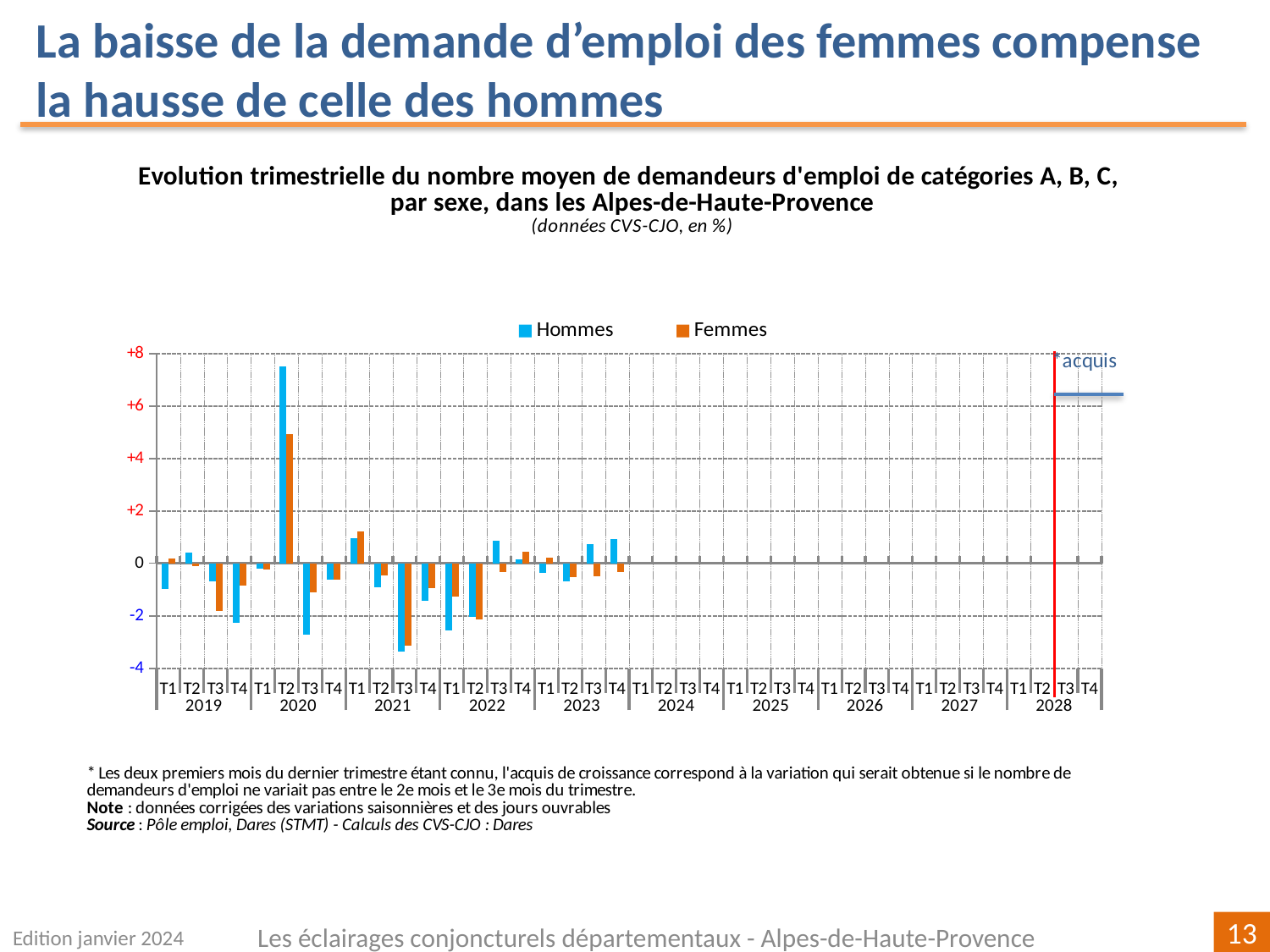
Is the Femmes value for T2 2020 greater or less than +4? greater In T2 2020, which series has the larger value, Hommes or Femmes? Hommes In which quarter does the Hommes series reach its lowest value? T3 2021 What kind of chart is shown on the slide? bar chart In which quarter does the Hommes series reach its highest value? T2 2020 Is the Hommes value for T3 2021 greater or less than -2? less In T3 2019, which series has the lower value, Hommes or Femmes? Femmes Is the Femmes value for T3 2021 greater or less than -2? less What label is written next to the red vertical line on the right of the chart? acquis What are the two series named in the legend? Hommes and Femmes How many series does the legend list? 2